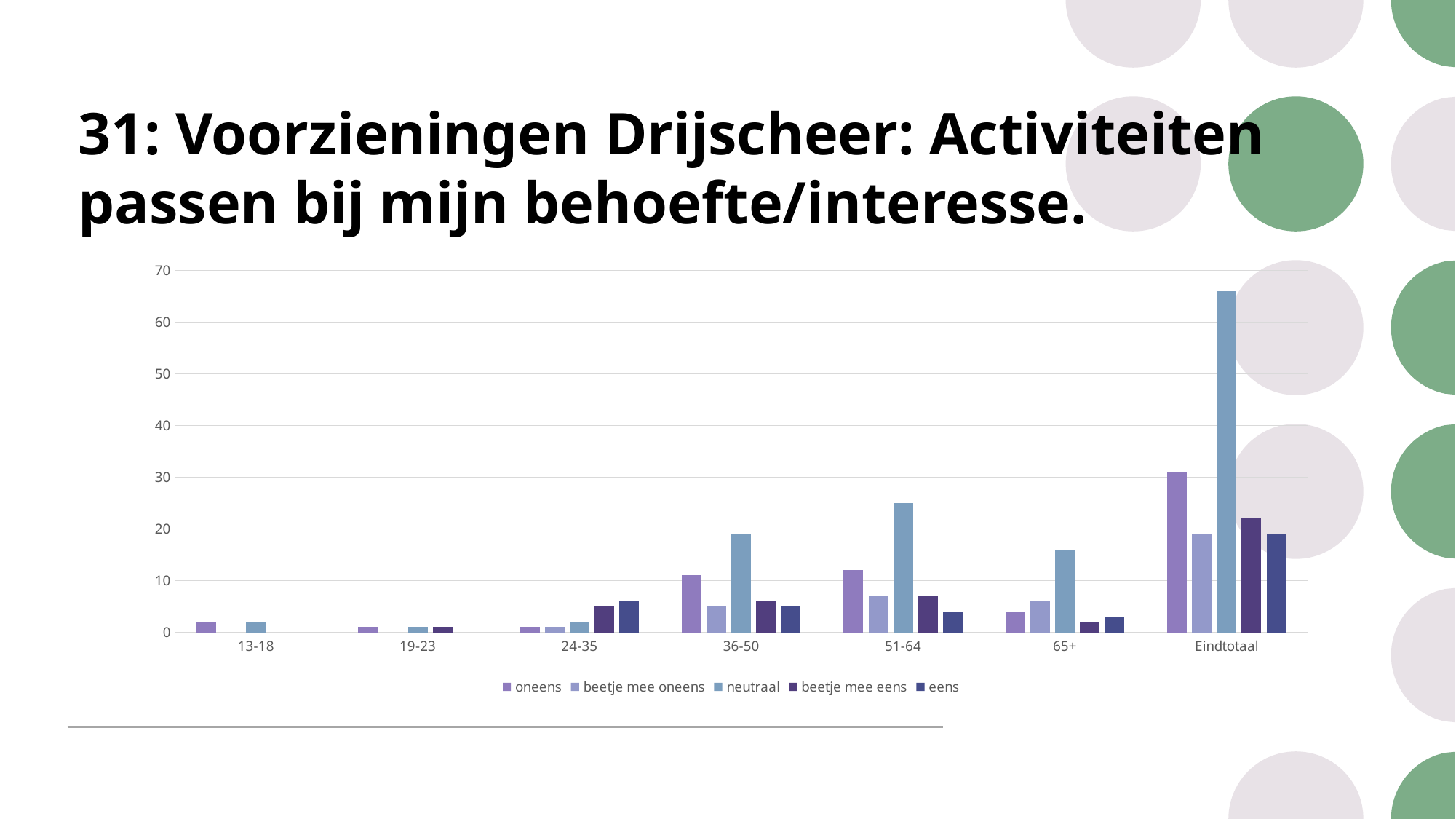
What is the last entry in the legend? eens Which is larger: the oneens value for 36-50 or for 65+? 36-50 Is the value for neutraal in the Eindtotaal category greater or less than 60? greater Is the value for oneens in the Eindtotaal category greater or less than 20? greater Which category has the highest value for neutraal? Eindtotaal How many series does the legend list? 5 Is the value for neutraal in the 51-64 category greater or less than 20? greater Which series has the tallest bar in the Eindtotaal category? neutraal What kind of chart is shown on the slide? bar chart Which is larger: the neutraal value for 51-64 or for 36-50? 51-64 How many categories are shown on the x axis? 7